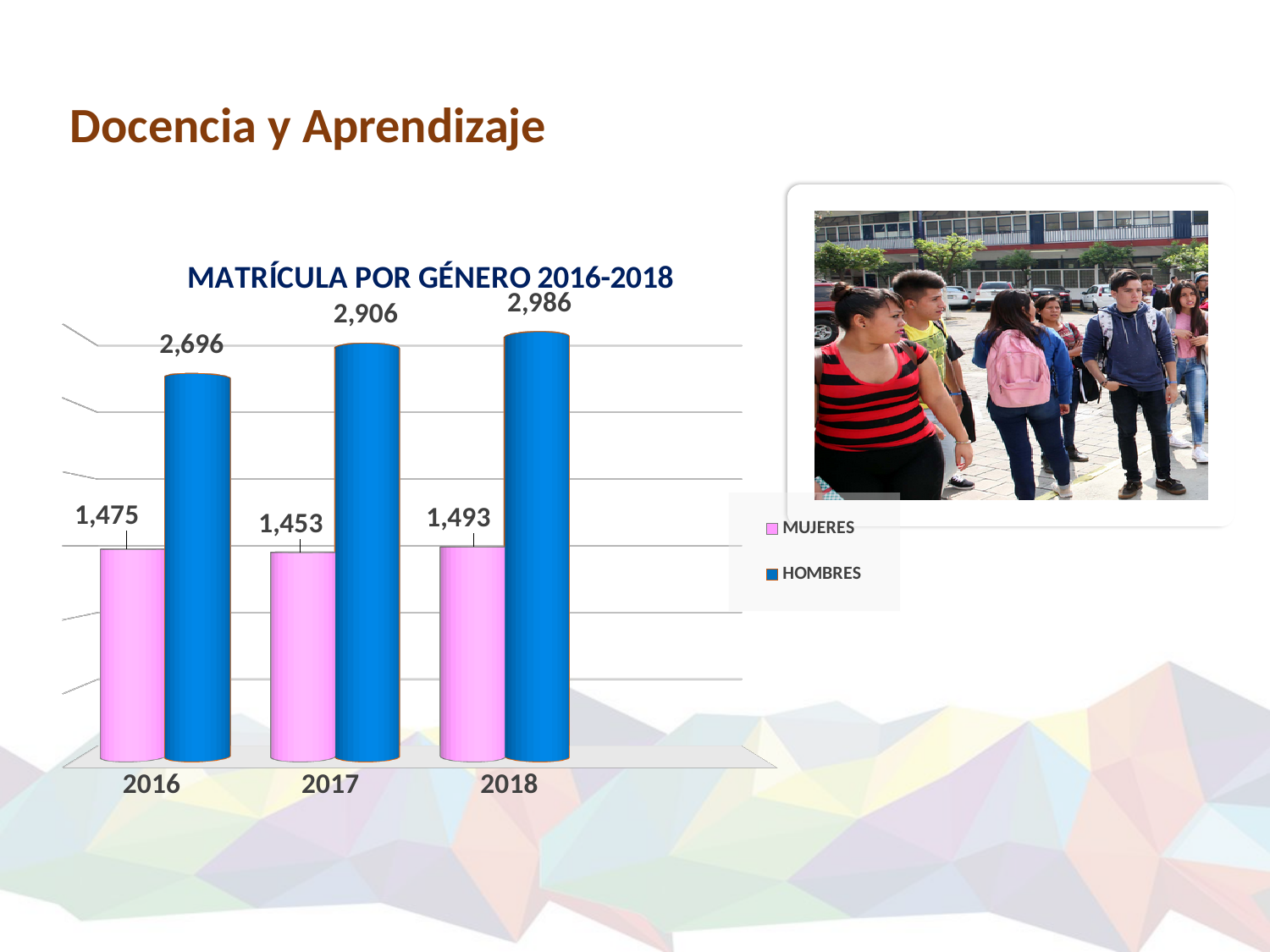
Which is larger in 2016, HOMBRES or MUJERES? HOMBRES How many series does the legend list? 2 What is the difference between HOMBRES and MUJERES in 2018? 1,493 What is the value for MUJERES in 2017? 1,453 In which year is the HOMBRES value highest? 2018 What is the title of the chart? MATRÍCULA POR GÉNERO 2016-2018 What kind of chart is shown? Bar chart How many years are shown on the x axis? 3 What is the value for HOMBRES in 2018? 2,986 What is the value for HOMBRES in 2016? 2,696 What is the difference between the HOMBRES values for 2017 and 2016? 210 In which year is the MUJERES value lowest? 2017